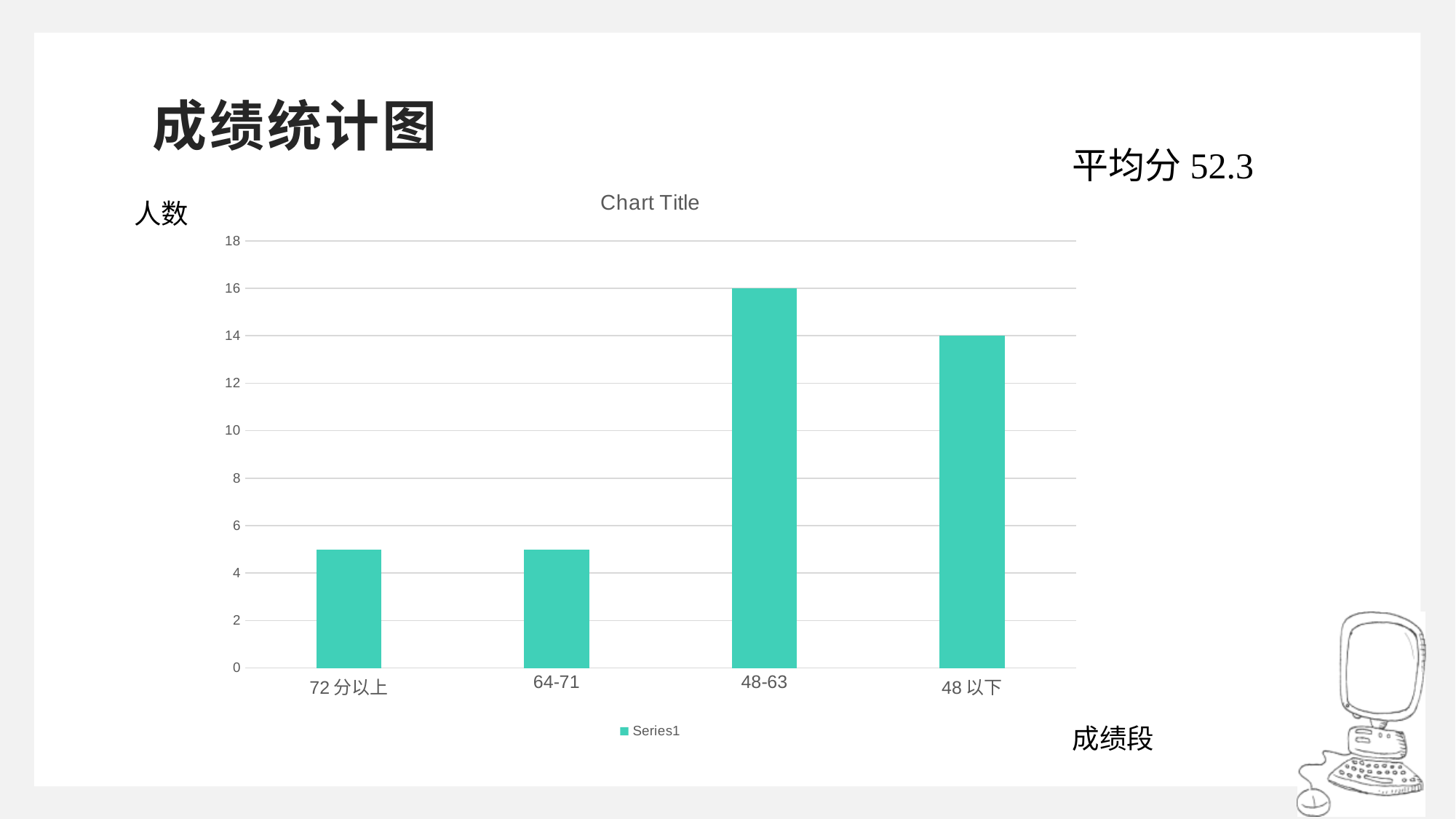
Which category has the highest value? 48-63 What kind of chart is shown on the slide? bar chart What is the value (人数) for the 48-63 category? 16 What is the title shown above the chart? Chart Title How many series does the legend list? 1 Is the value for 72 分以上 greater or less than 6? less What is the value (人数) for the 48 以下 category? 14 Is the value for 64-71 greater or less than 4? greater Which is larger, the value for 72 分以上 or the value for 48 以下? 48 以下 How many score-range categories are shown on the x axis? 4 What is the difference between the values for 48-63 and 48 以下? 2 Which is larger, the value for 48-63 or the value for 48 以下? 48-63